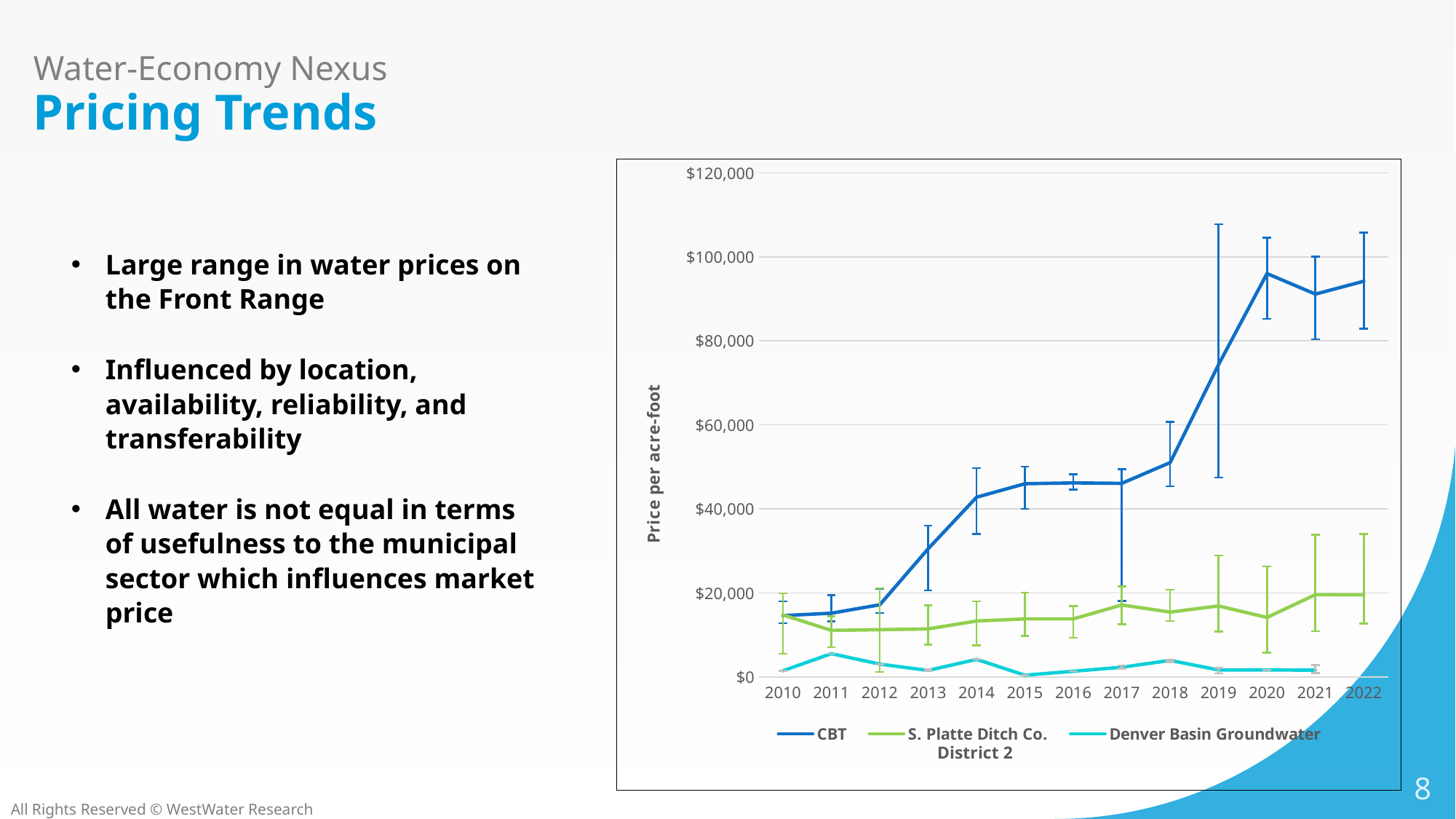
Does the CBT line generally rise or fall from 2010 to 2022? Rise Is the CBT value for 2020 greater or less than $80,000? greater In 2022, which is larger: the CBT value or the S. Platte Ditch Co. District 2 value? CBT Is the S. Platte Ditch Co. District 2 value for 2022 greater or less than $40,000? less Which series has the highest value in 2022? CBT Which series has the lowest values across the chart? Denver Basin Groundwater What is the title of the chart's vertical axis? Price per acre-foot How many series does the chart's legend list? 3 What kind of chart is shown on the slide? Line chart How many years are plotted along the x axis of the chart? 13 Is the CBT value for 2016 greater or less than $40,000? greater